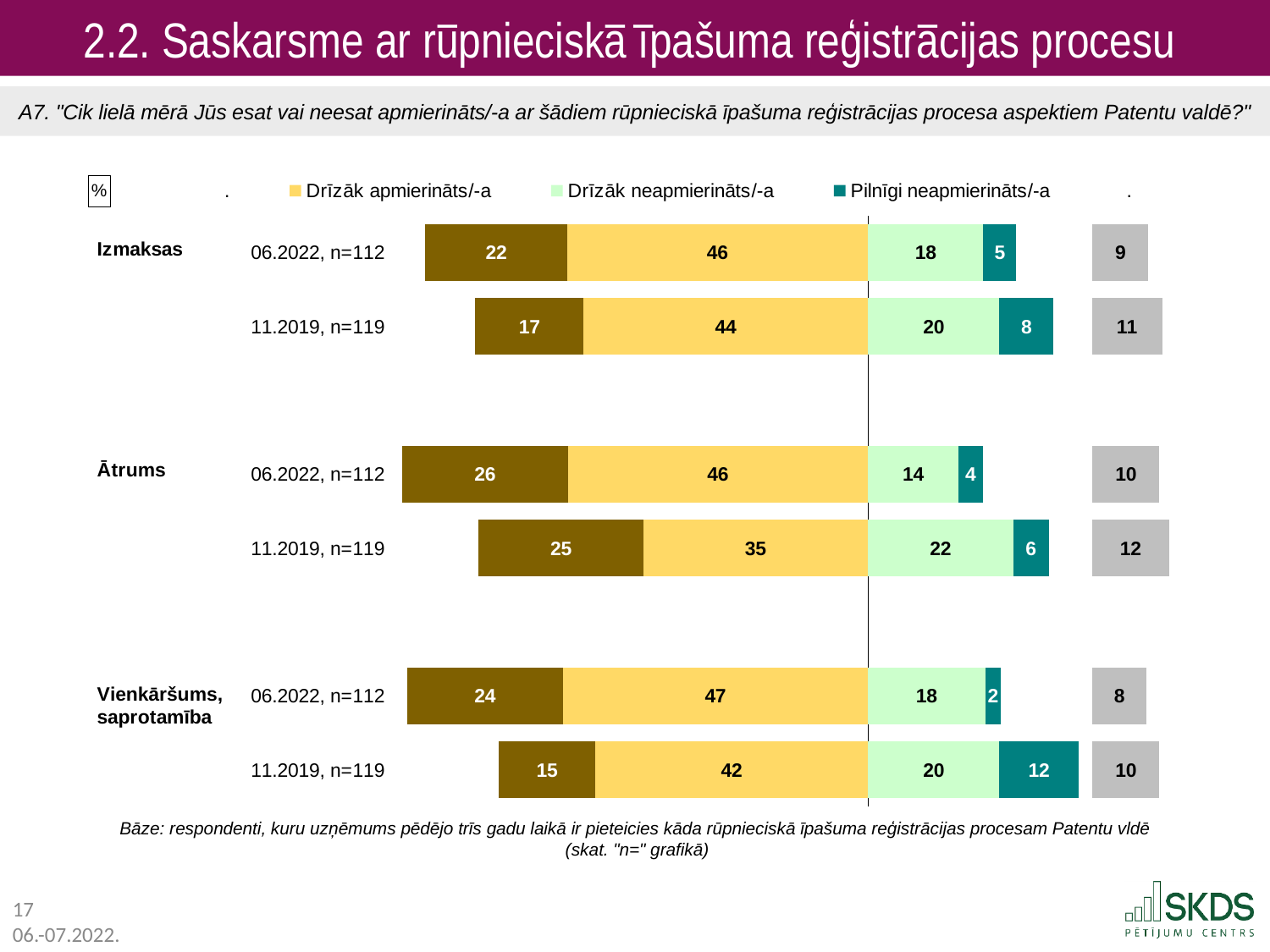
Which row has the highest value for "Drīzāk apmierināts/-a"? Vienkāršums, saprotamība, 06.2022, n=112 What is the value of "Drīzāk neapmierināts/-a" for Ātrums, 11.2019, n=119? 22 What value is shown in the grey box at the right end of the Ātrums, 11.2019, n=119 row? 12 What is the combined value of "Drīzāk neapmierināts/-a" and "Pilnīgi neapmierināts/-a" for Izmaksas, 11.2019, n=119? 28 What is the value of "Pilnīgi neapmierināts/-a" for Vienkāršums, saprotamība, 11.2019, n=119? 12 How many stacked bars are shown in the chart? 6 For Izmaksas, is "Drīzāk neapmierināts/-a" larger in 06.2022 or in 11.2019? 11.2019 Did "Drīzāk apmierināts/-a" for Vienkāršums, saprotamība rise or fall from 11.2019 to 06.2022? Rise What type of chart is shown on the slide? Stacked bar chart Which row has the lowest value for "Pilnīgi neapmierināts/-a"? Vienkāršums, saprotamība, 06.2022, n=112 What is the value of "Drīzāk apmierināts/-a" for Izmaksas, 06.2022, n=112? 46 What is the difference in "Drīzāk apmierināts/-a" for Ātrums between 06.2022 and 11.2019? 11